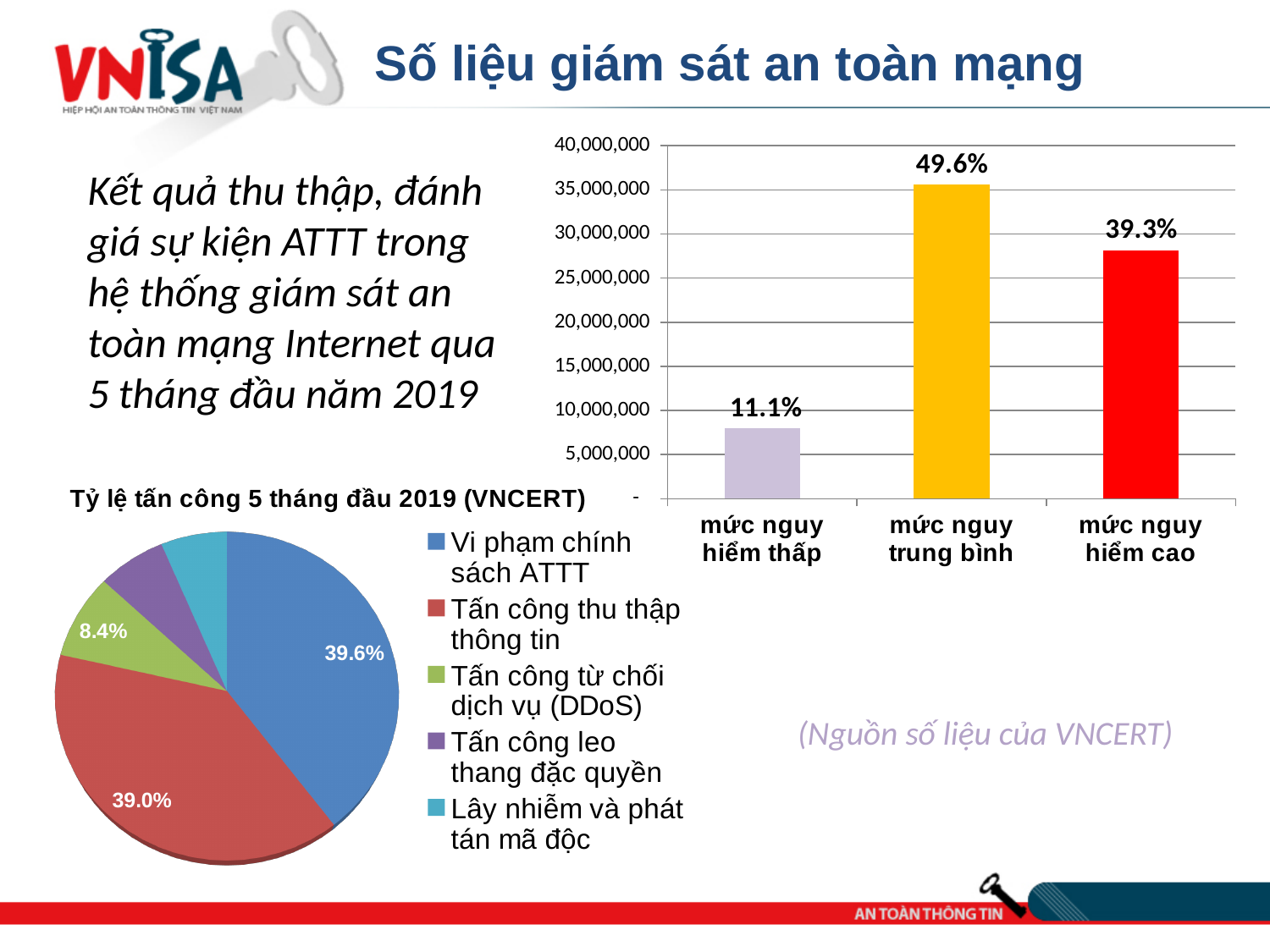
In the bar chart on the right, what data label is shown for 'mức nguy hiểm cao'? 39.3% In the bar chart on the right, which category has the tallest bar? mức nguy trung bình In the pie chart 'Tỷ lệ tấn công 5 tháng đầu 2019 (VNCERT)', what share is labelled on the green slice for 'Tấn công từ chối dịch vụ (DDoS)'? 8.4% In the bar chart on the right, is the value for 'mức nguy trung bình' greater or less than 30,000,000? greater In the bar chart on the right, what is the difference between the percentage labels for 'mức nguy trung bình' and 'mức nguy hiểm cao'? 10.3% In the pie chart 'Tỷ lệ tấn công 5 tháng đầu 2019 (VNCERT)', what share is labelled on the blue slice for 'Vi phạm chính sách ATTT'? 39.6% In the bar chart on the right, what data label is shown above the bar for 'mức nguy trung bình'? 49.6% In the bar chart on the right, is the value for 'mức nguy hiểm thấp' greater or less than 10,000,000? less In the pie chart 'Tỷ lệ tấn công 5 tháng đầu 2019 (VNCERT)', which is larger: the slice labelled 39.6% or the slice labelled 39.0%? 39.6% In the bar chart on the right, which category has the shortest bar? mức nguy hiểm thấp In the pie chart 'Tỷ lệ tấn công 5 tháng đầu 2019 (VNCERT)', how many entries does the legend list? 5 In the bar chart on the right, how many categories are shown on the x axis? 3